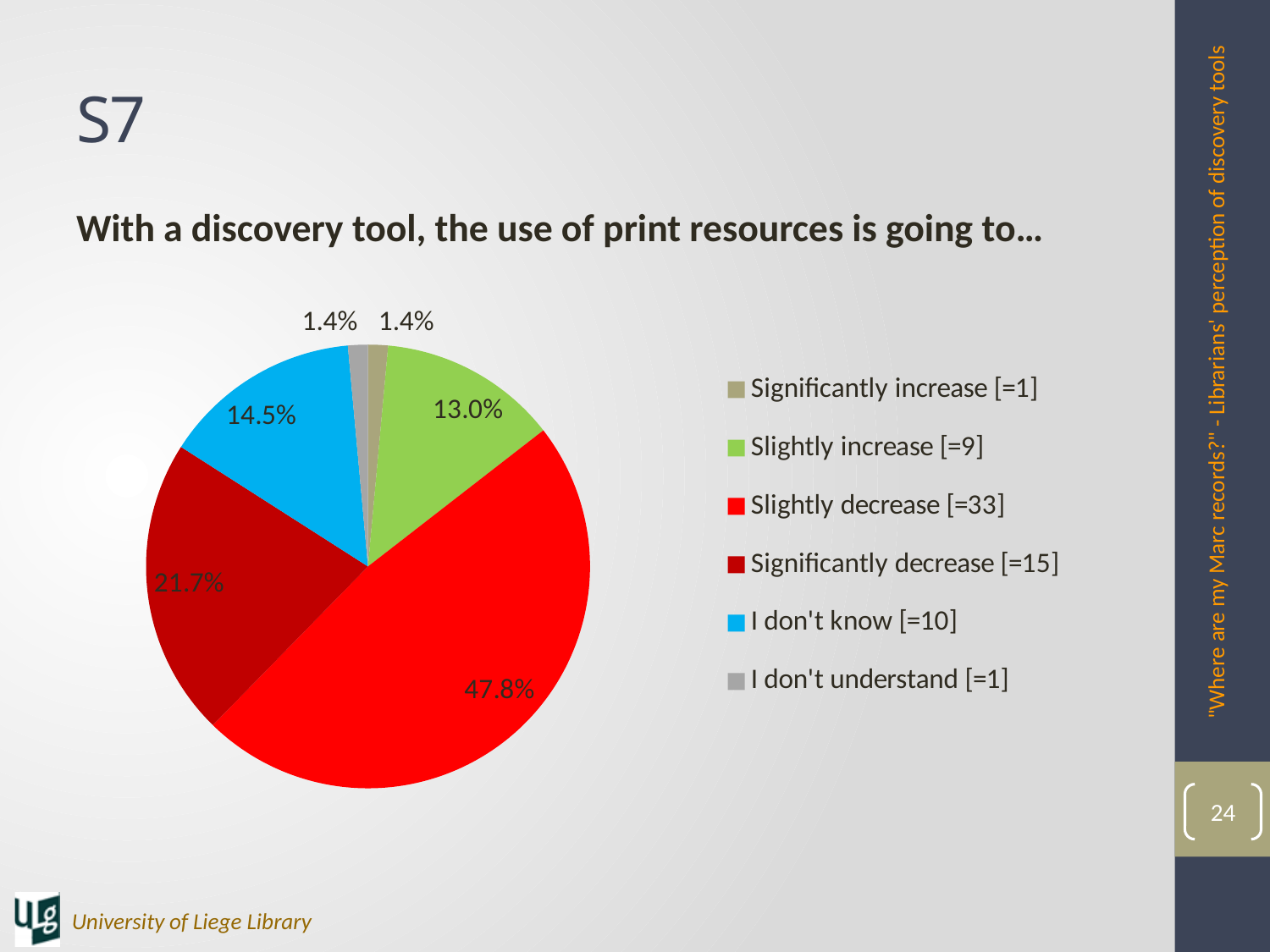
Which is larger: the 'Significantly decrease' slice or the 'I don't know' slice? Significantly decrease What percentage of the pie is the 'I don't know' slice? 14.5% How many respondents chose 'I don't know' according to the legend? 10 How many categories does the legend list? 6 What colour is the 'I don't know' slice? light blue What kind of chart is shown on the slide? pie chart How many respondents chose 'Slightly decrease' according to the legend? 33 What percentage of the pie is the 'Slightly increase' slice? 13.0% What is the difference in percentage points between the 'Slightly decrease' and 'Significantly decrease' slices? 26.1 What percentage of the pie is the 'Slightly decrease' slice? 47.8% Which category has the largest share of the pie? Slightly decrease What percentage of the pie is the 'Significantly decrease' slice? 21.7%